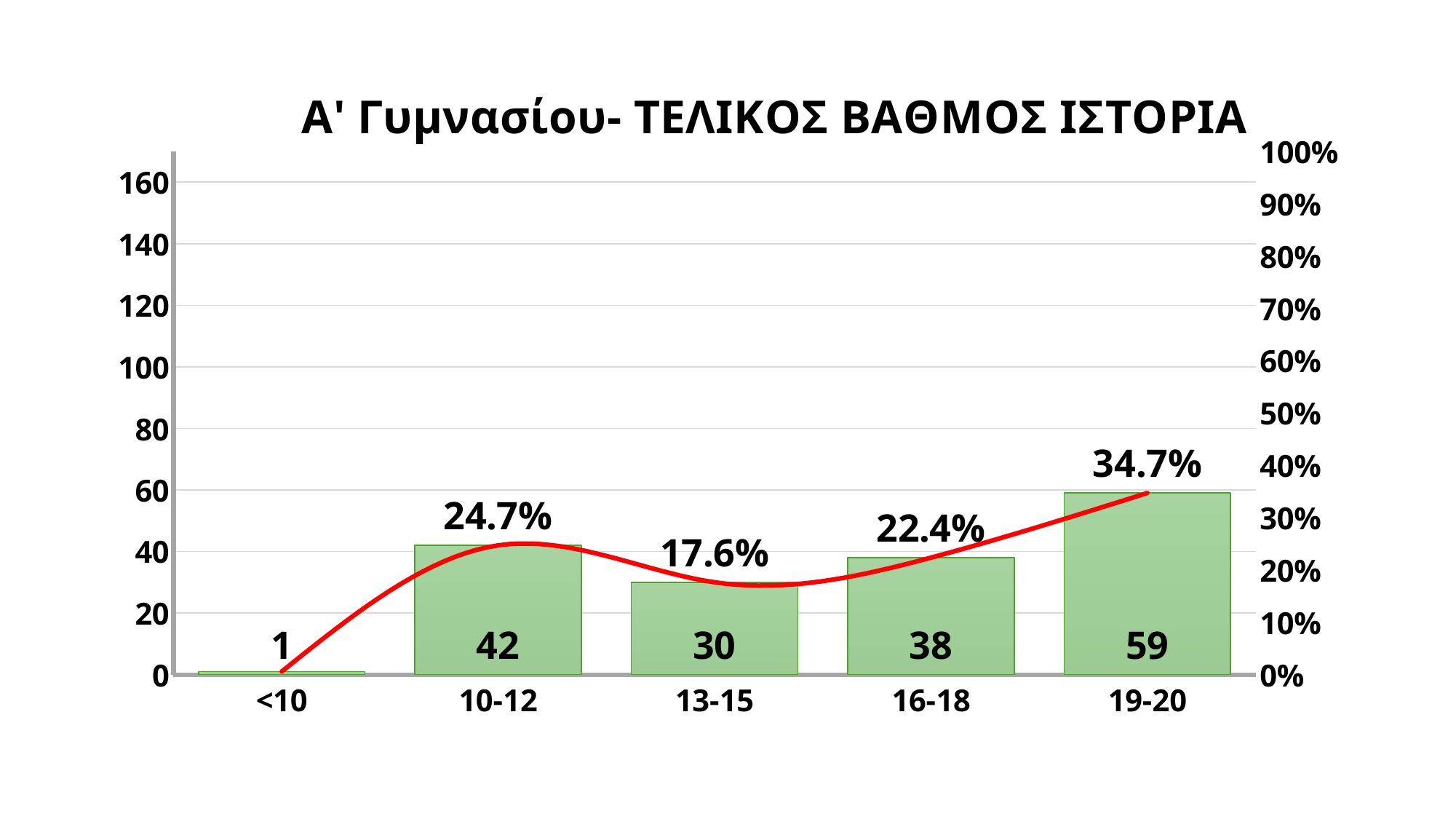
What percentage is shown for the 16-18 grade band? 22.4% Which grade band has the lowest count? <10 Which has a larger count, the 13-15 band or the 16-18 band? 16-18 What is the title of the chart? Α' Γυμνασίου- ΤΕΛΙΚΟΣ ΒΑΘΜΟΣ ΙΣΤΟΡΙΑ What is the count shown for the 19-20 grade band? 59 What percentage is shown for the 10-12 grade band? 24.7% What is the count shown for the 13-15 grade band? 30 Is the count for the 10-12 grade band greater or less than 60? less How many grade bands are shown on the x axis? 5 What is the total of the counts across all five grade bands? 170 What is the difference between the counts for the 19-20 and 10-12 grade bands? 17 Which grade band has the highest count? 19-20